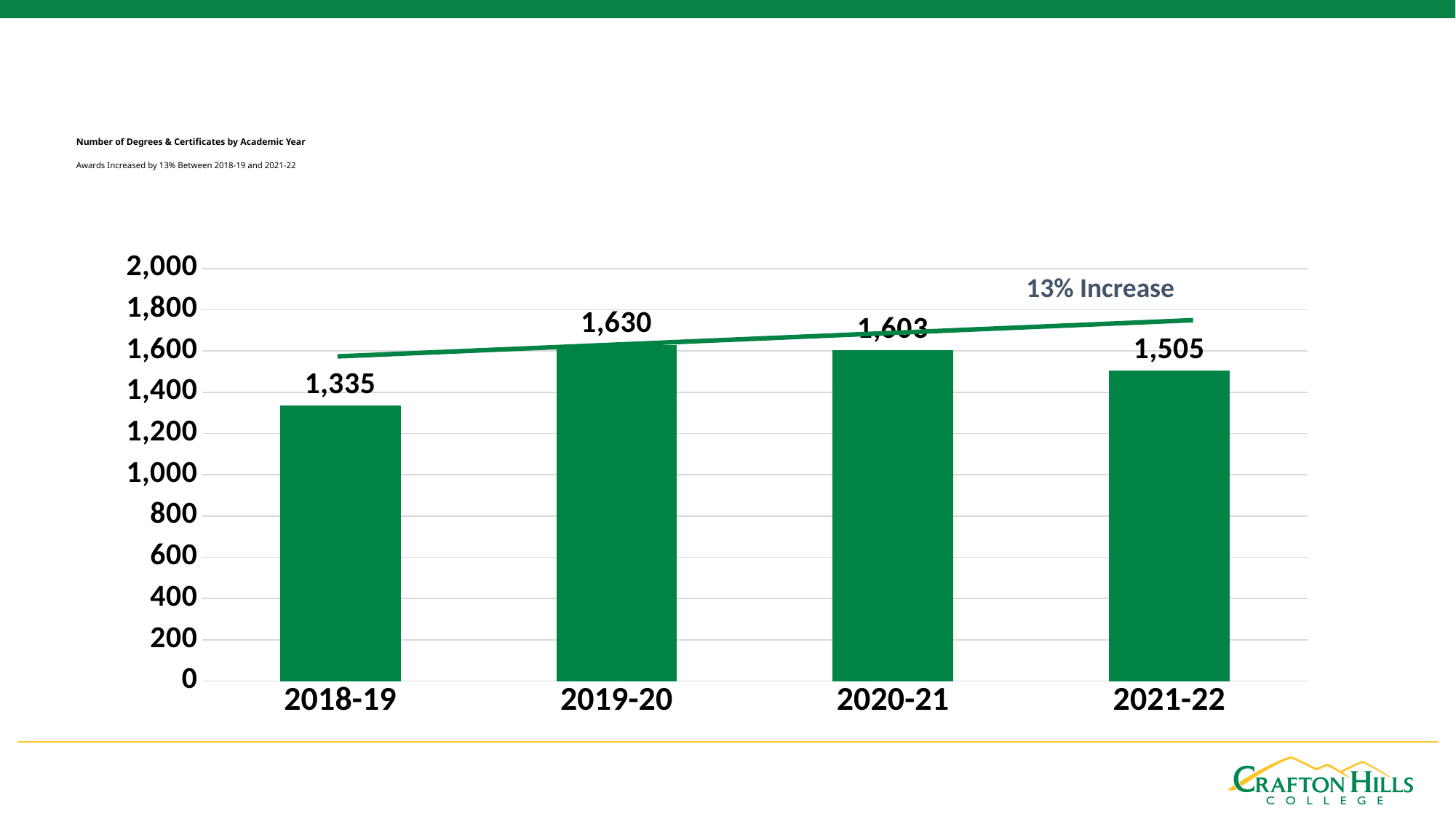
Is the value for 2018-19 greater or less than 1,400? less How many more degrees and certificates were awarded in 2019-20 than in 2018-19? 295 What kind of chart is shown on the slide? bar chart What is the number of degrees and certificates for 2018-19? 1,335 Which academic year has the highest number of degrees and certificates? 2019-20 What label is shown next to the trend line on the chart? 13% Increase How many academic years are shown on the chart? 4 Which academic year has the lowest number of degrees and certificates? 2018-19 Which year has the larger value, 2018-19 or 2021-22? 2021-22 What is the number of degrees and certificates for 2021-22? 1,505 What is the number of degrees and certificates for 2019-20? 1,630 How many more degrees and certificates were awarded in 2021-22 than in 2018-19? 170